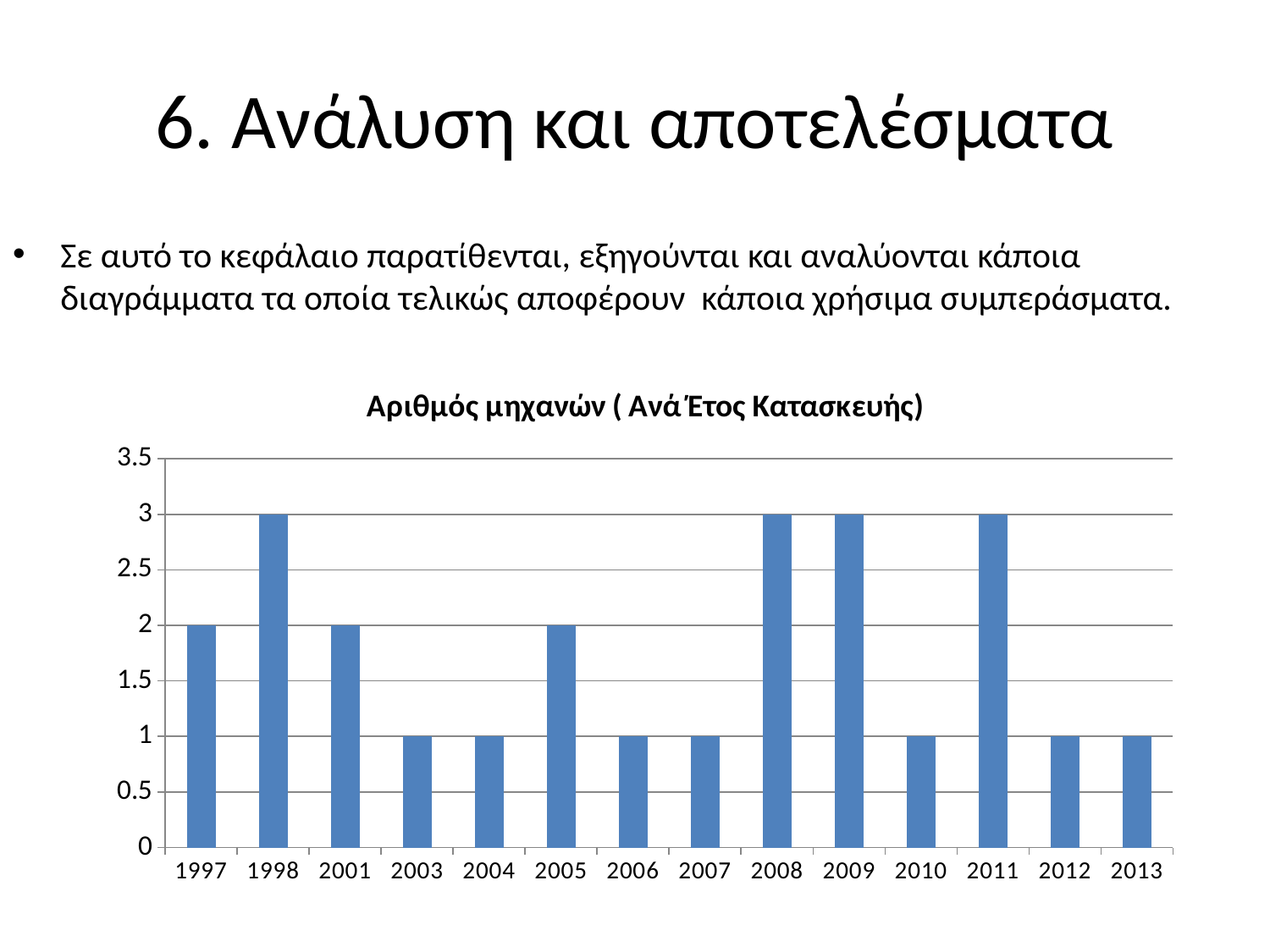
What is the value for 2010? 1 What is the difference between the values for 2009 and 2012? 2 What is the highest value reached by any bar in the chart? 3 What is the value for 1998? 3 What is the value for 2005? 2 How many years (categories) are shown on the x axis of the chart? 14 Which has a larger value, 2011 or 2013? 2011 Is the value for 2008 greater or less than 2.5? greater What is the value for 1997? 2 What kind of chart is shown on the slide? bar chart What is the title of the chart? Αριθμός μηχανών ( Ανά Έτος Κατασκευής) What is the lowest value reached by any bar in the chart? 1